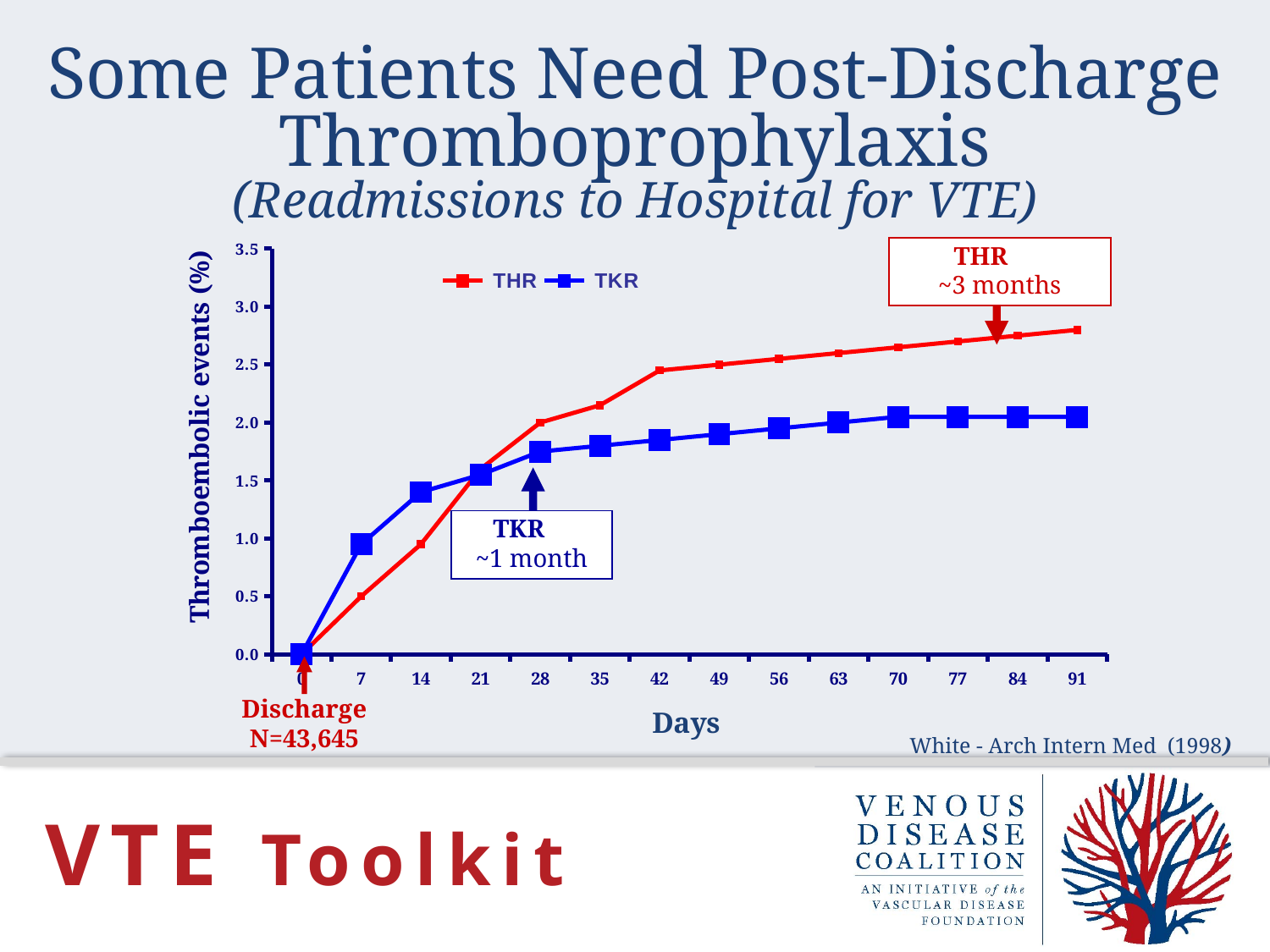
What is the value for THR at day 0? 0.0 How many day values are marked along the x axis? 14 At day 91, which series has the higher value, THR or TKR? THR How many series does the chart legend list? 2 Is the value for THR at day 7 greater or less than 1.0? less Which two series are listed in the chart legend? THR and TKR What is the value for THR at day 28? 2.0 What is the label of the y axis? Thromboembolic events (%) Is the value for TKR at day 91 greater or less than 2.5? less At day 14, which series has the higher value, THR or TKR? TKR What kind of chart is shown on the slide? line chart Is the value for THR at day 91 greater or less than 2.5? greater